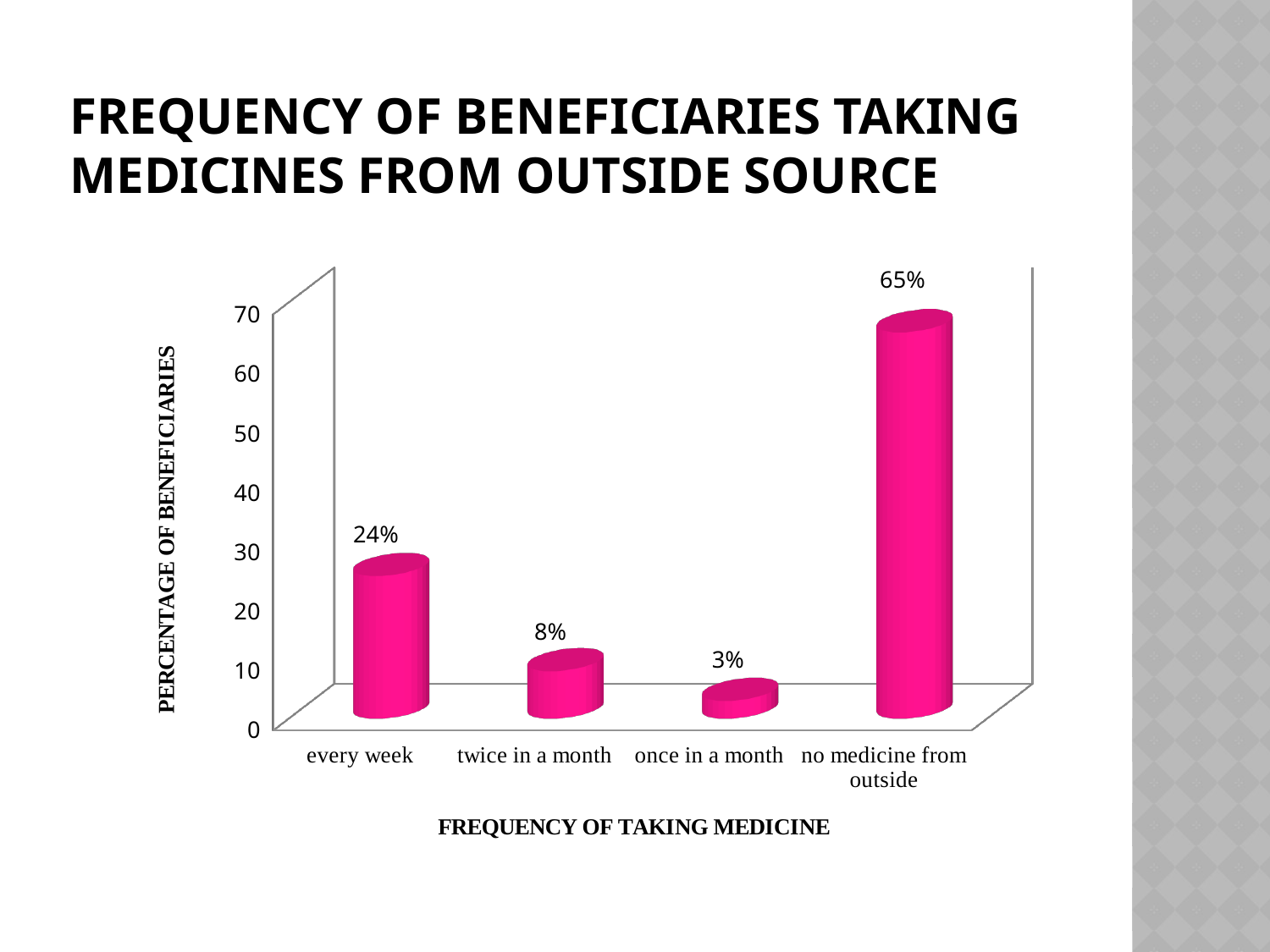
What kind of chart is shown on the slide? bar chart Is the value for 'no medicine from outside' greater or less than 60? greater What percentage of beneficiaries take no medicine from outside? 65% What is the difference between the 'no medicine from outside' value and the 'every week' value? 41% What is the value shown for 'twice in a month'? 8% What is the label of the x axis? FREQUENCY OF TAKING MEDICINE How many categories are shown on the x axis? 4 Which is larger, the value for 'every week' or the value for 'twice in a month'? every week Which category has the highest percentage of beneficiaries? no medicine from outside Which category has the lowest percentage of beneficiaries? once in a month What percentage of beneficiaries take medicines from an outside source every week? 24% What is the value shown for 'once in a month'? 3%